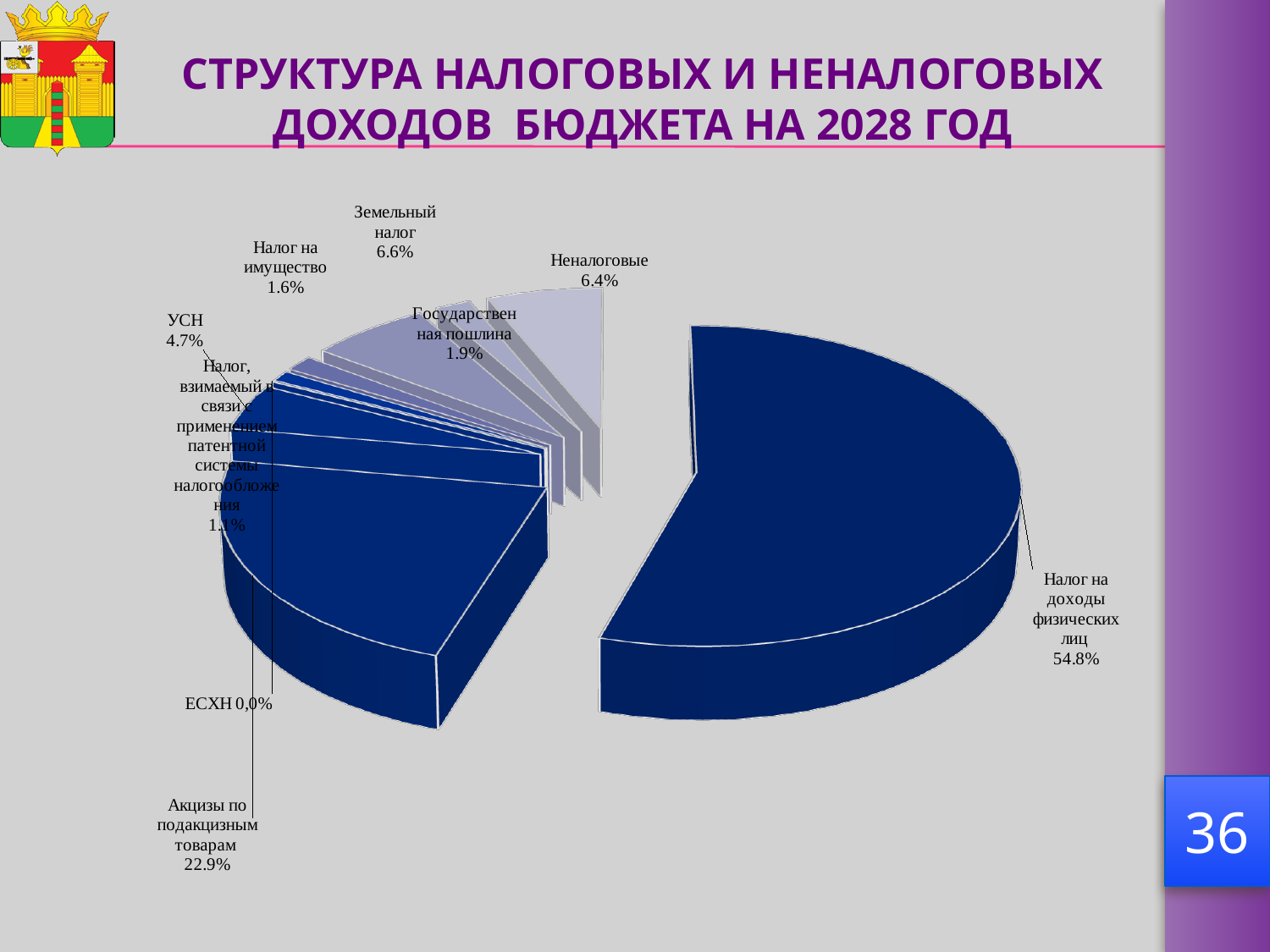
What kind of chart is shown on the slide? Pie chart Which category has the smallest share of the pie? ЕСХН What is the difference between the shares of "Налог на доходы физических лиц" and "Акцизы по подакцизным товарам"? 31.9% Which is larger, the share for "Налог на имущество" or the share for "УСН"? УСН What is the value shown for "Государственная пошлина"? 1.9% How many categories are shown in the pie chart? 9 What is the value shown for "Неналоговые"? 6.4% Which category has the largest share of the pie? Налог на доходы физических лиц What is the value shown for "Земельный налог"? 6.6% What share of the pie does "Налог на доходы физических лиц" have? 54.8% What is the value shown for "Акцизы по подакцизным товарам"? 22.9% What is the value shown for "УСН"? 4.7%